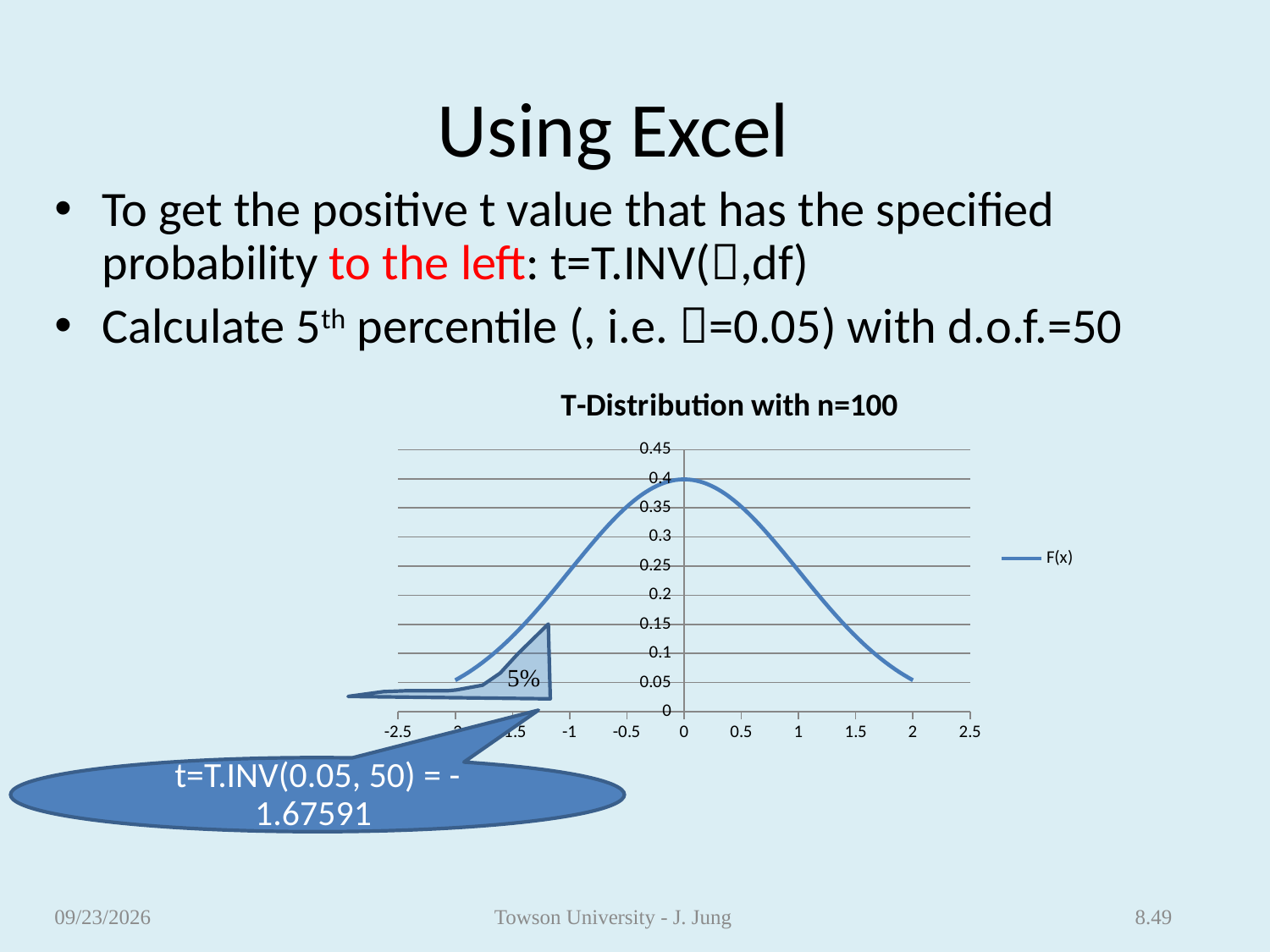
How many series does the chart legend list? 1 Is the value of F(x) at x=0 greater or less than 0.35? greater At which x value does the F(x) curve reach its highest point? 0 Is the value of F(x) at x=-1.5 greater or less than 0.2? less Does the F(x) curve rise or fall as x goes from 0 to 2? fall Is the value of F(x) at x=1 greater or less than 0.2? greater What is the highest tick value shown on the vertical axis of the chart? 0.45 What is the name of the series shown in the chart legend? F(x) Does the F(x) curve rise or fall as x goes from -2 to 0? rise What is the title of the chart? T-Distribution with n=100 What kind of chart is shown on the slide? line chart